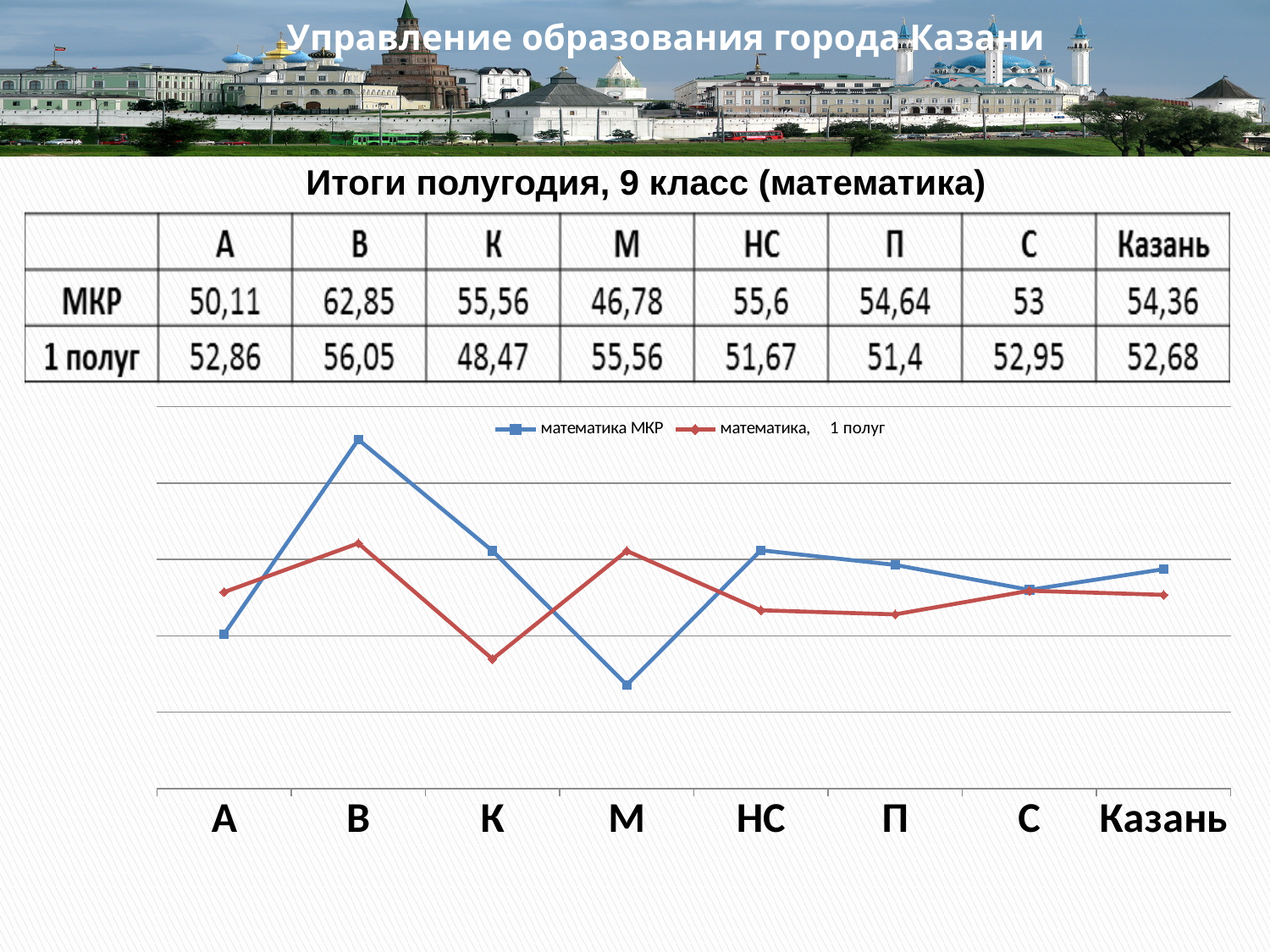
Which category has the lowest value for the series 'математика, 1 полуг'? К At category М, which series has the larger value: 'математика МКР' or 'математика, 1 полуг'? математика, 1 полуг Which category has the highest value for the series 'математика МКР'? В At category В, which series has the larger value: 'математика МКР' or 'математика, 1 полуг'? математика МКР What is the title of the slide above the table and chart? Итоги полугодия, 9 класс (математика) How many categories are shown along the x axis of the chart? 8 Which category has the lowest value for the series 'математика МКР'? М What kind of chart is shown on the slide? line chart How many series does the chart legend list? 2 What is the value of 'математика МКР' for category В, as printed in the table? 62,85 Which category has the highest value for the series 'математика, 1 полуг'? В Does the 'математика МКР' line rise or fall from category В to category М? fall